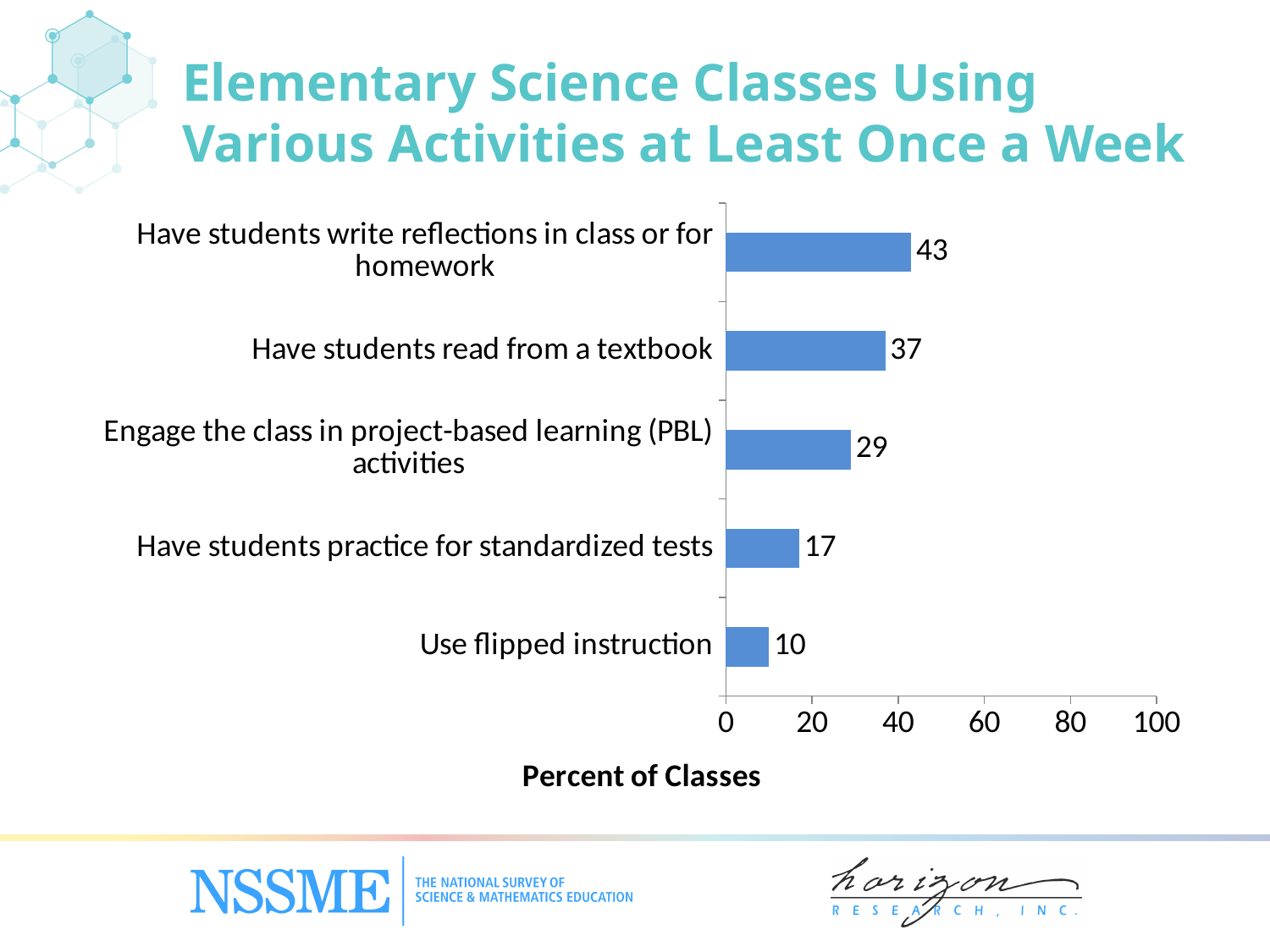
Which is larger: the value for 'Engage the class in project-based learning (PBL) activities' or 'Have students practice for standardized tests'? Engage the class in project-based learning (PBL) activities What is the difference between the values for 'Have students read from a textbook' and 'Have students practice for standardized tests'? 20 Which activity has the lowest percent of classes? Use flipped instruction What is the value for 'Use flipped instruction'? 10 How many activities are shown in the chart? 5 What is the label of the horizontal axis? Percent of Classes Is the value for 'Have students write reflections in class or for homework' greater or less than 40? greater What percent of classes have students write reflections in class or for homework at least once a week? 43 What percent of classes engage the class in project-based learning (PBL) activities at least once a week? 29 What kind of chart is shown on the slide? Bar chart Which activity has the highest percent of classes? Have students write reflections in class or for homework What is the value for 'Have students read from a textbook'? 37